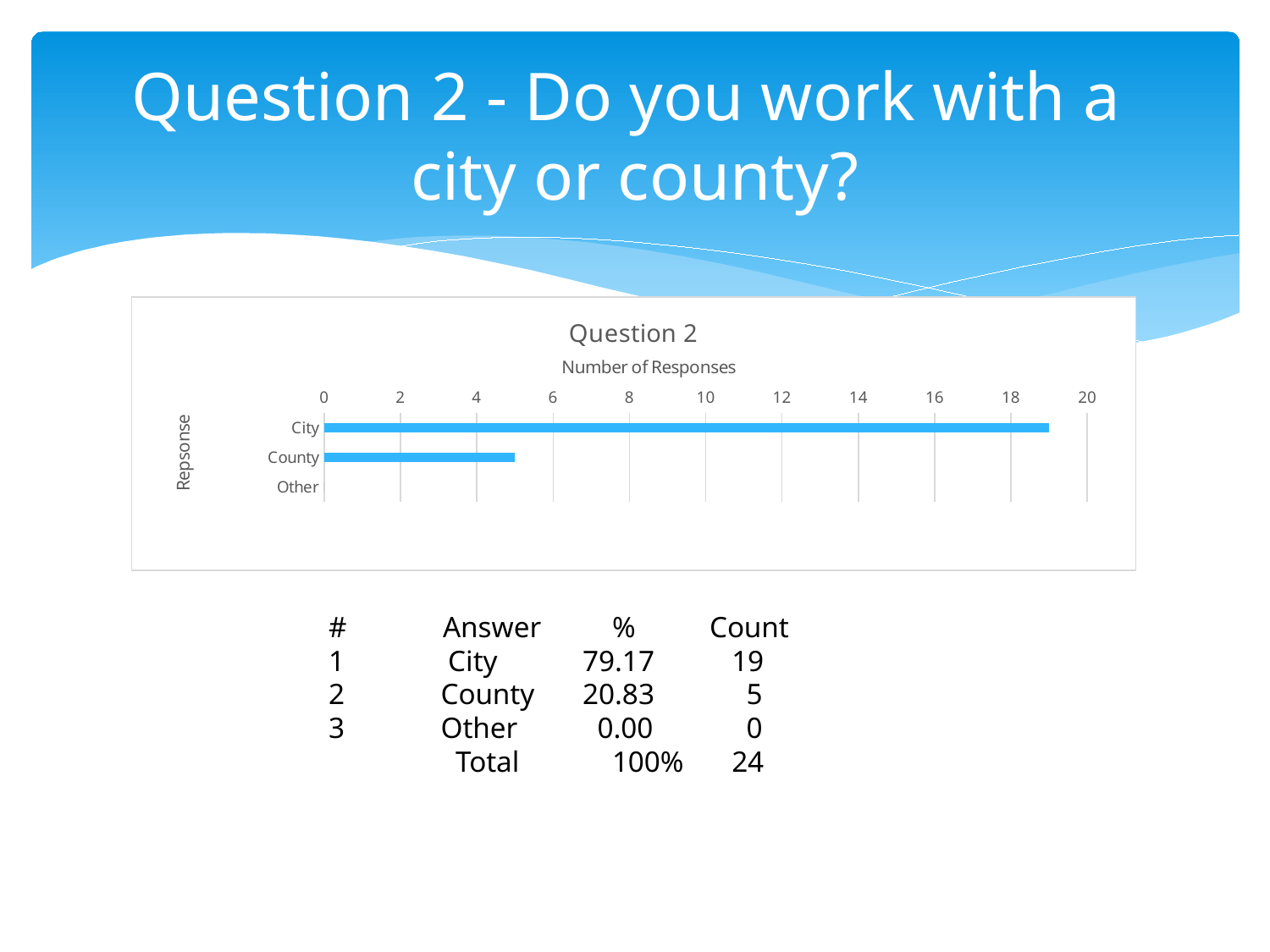
What type of chart is shown on the slide? bar chart How many categories are shown on the chart's vertical axis? 3 What is the title of the chart? Question 2 What is the difference in responses between City and County? 14 Is the number of responses for City greater or less than 18? greater Which category has the highest number of responses? City How many responses does City have according to the slide? 19 What is the label on the horizontal axis of the chart? Number of Responses Which has more responses, City or County? City Is the number of responses for County greater or less than 6? less How many responses does County have according to the slide? 5 Which category has the lowest number of responses? Other